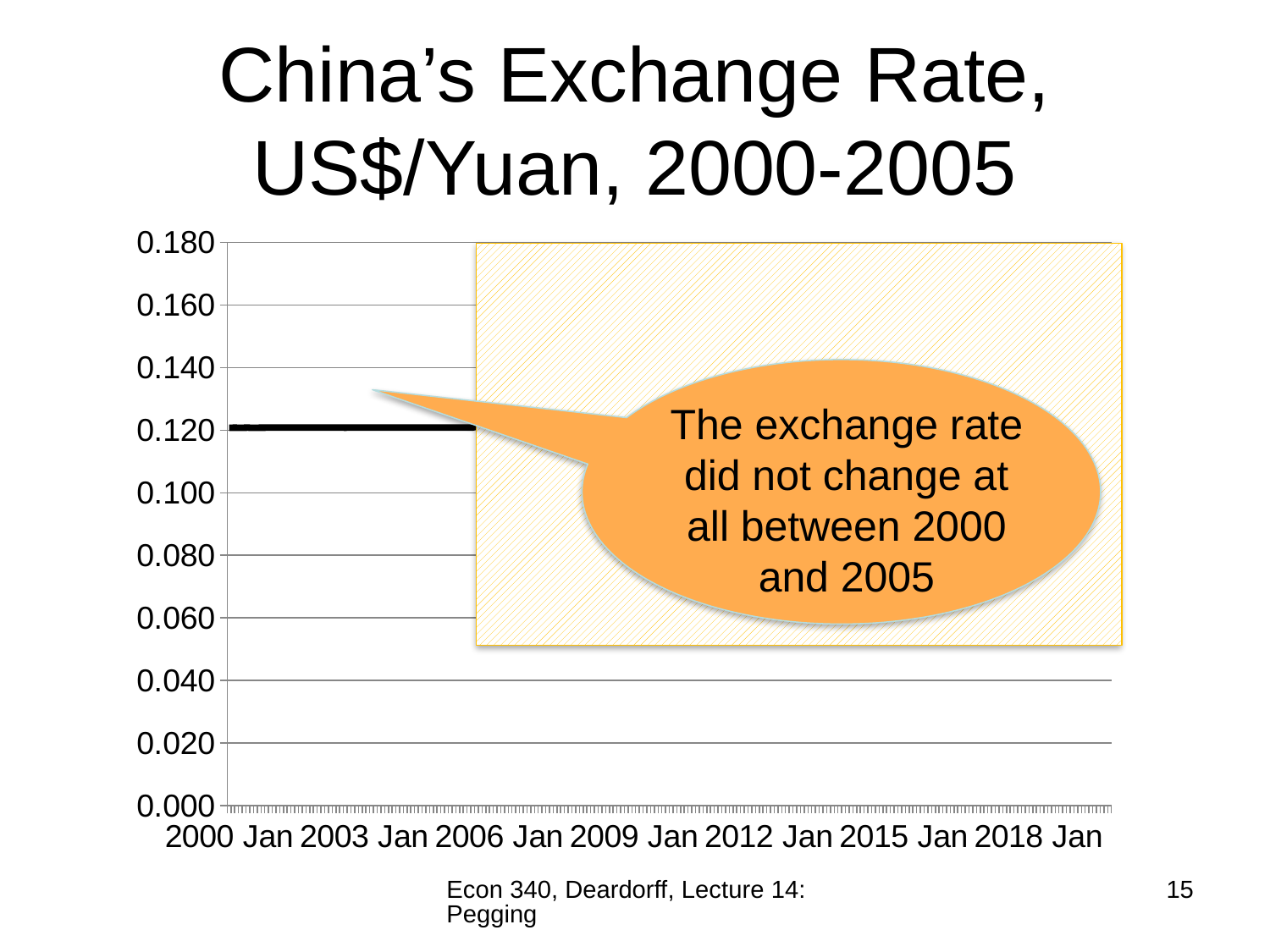
What is the highest value shown on the vertical axis? 0.180 What is the title of the chart? China's Exchange Rate, US$/Yuan, 2000-2005 Is the exchange rate value in 2003 Jan greater or less than 0.100? greater Is the exchange rate value at 2000 Jan greater or less than 0.080? greater What does the callout on the chart say? The exchange rate did not change at all between 2000 and 2005 Does the plotted exchange rate rise, fall, or stay flat between 2000 and 2005? stays flat What kind of chart is shown on the slide? line chart Is the exchange rate value in 2003 Jan greater or less than 0.140? less